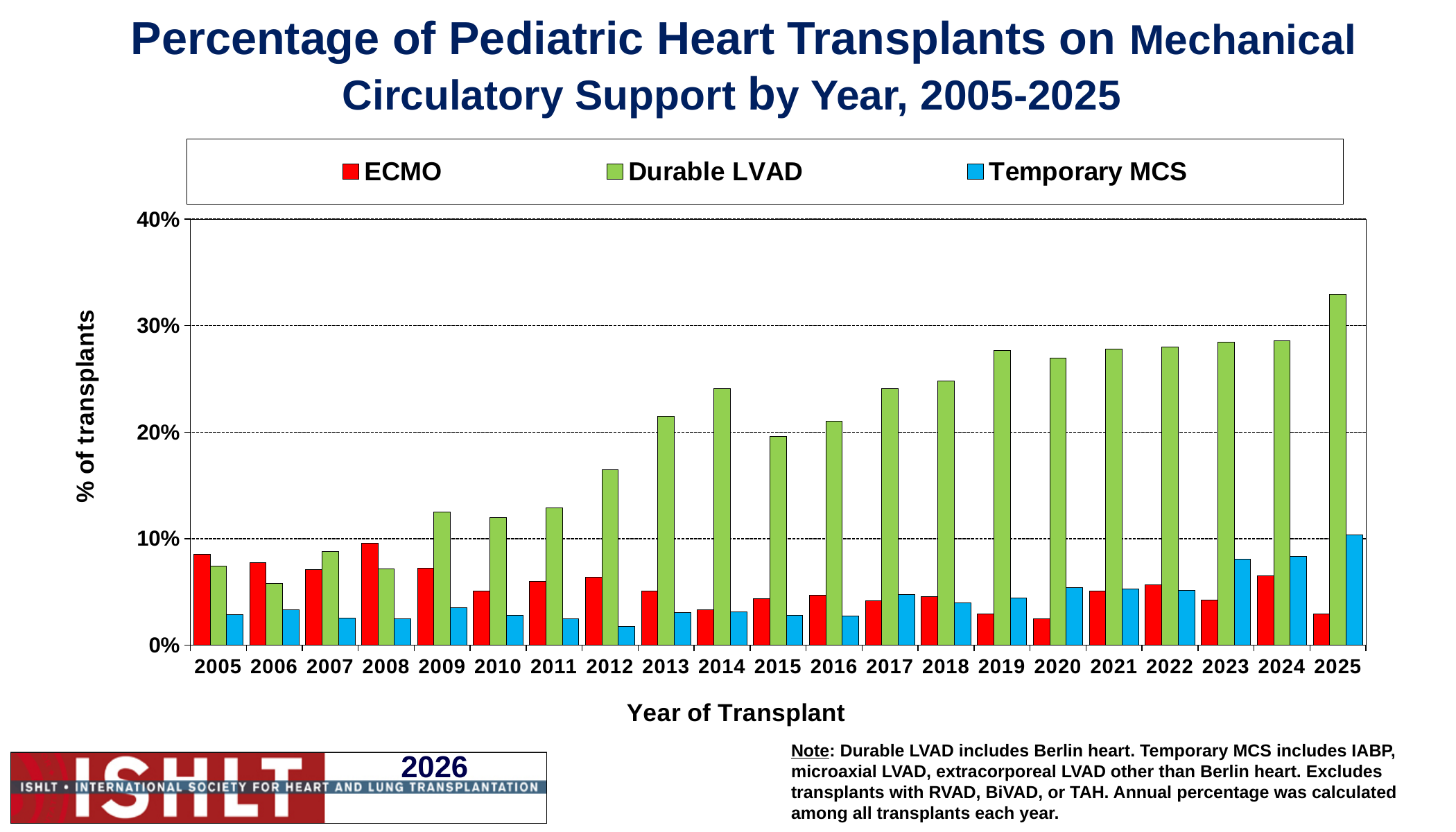
In which year is the Durable LVAD percentage highest? 2025 In which year is the Temporary MCS percentage highest? 2025 In 2025, which is larger: the ECMO value or the Durable LVAD value? Durable LVAD What is the title of the x axis? Year of Transplant Is the Durable LVAD value for 2013 greater or less than 20%? greater In 2008, which is larger: the ECMO value or the Durable LVAD value? ECMO How many series does the legend list? 3 What kind of chart is shown on the slide? bar chart How many years are shown on the x axis? 21 Is the Durable LVAD value for 2025 greater or less than 30%? greater Is the Durable LVAD value for 2005 greater or less than 10%? less Does the Durable LVAD percentage generally rise or fall from 2005 to 2025? rise